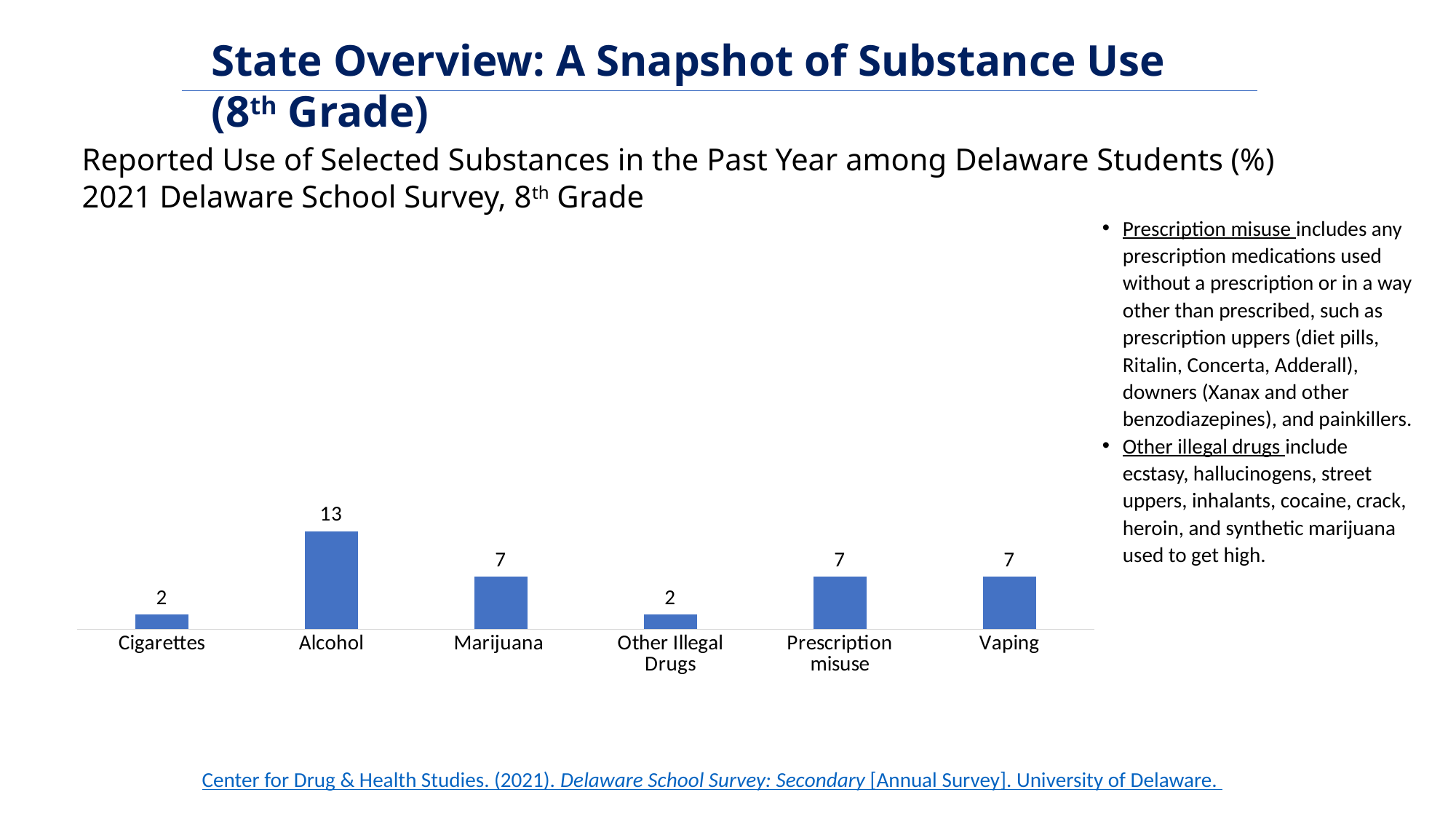
What is the value shown for Vaping? 7 What is the reported past-year use value for Cigarettes? 2 Which substance has the highest reported past-year use? Alcohol How many substance categories are shown on the chart? 6 What is the difference between the values for Prescription misuse and Other Illegal Drugs? 5 What is the reported past-year use value for Alcohol? 13 What kind of chart is shown on the slide? Bar chart What is the difference between the values for Alcohol and Marijuana? 6 Which grade does the chart's data refer to? 8th Grade Which is larger, the value for Alcohol or the value for Vaping? Alcohol Which is larger, the value for Marijuana or the value for Cigarettes? Marijuana What is the value shown for Marijuana? 7